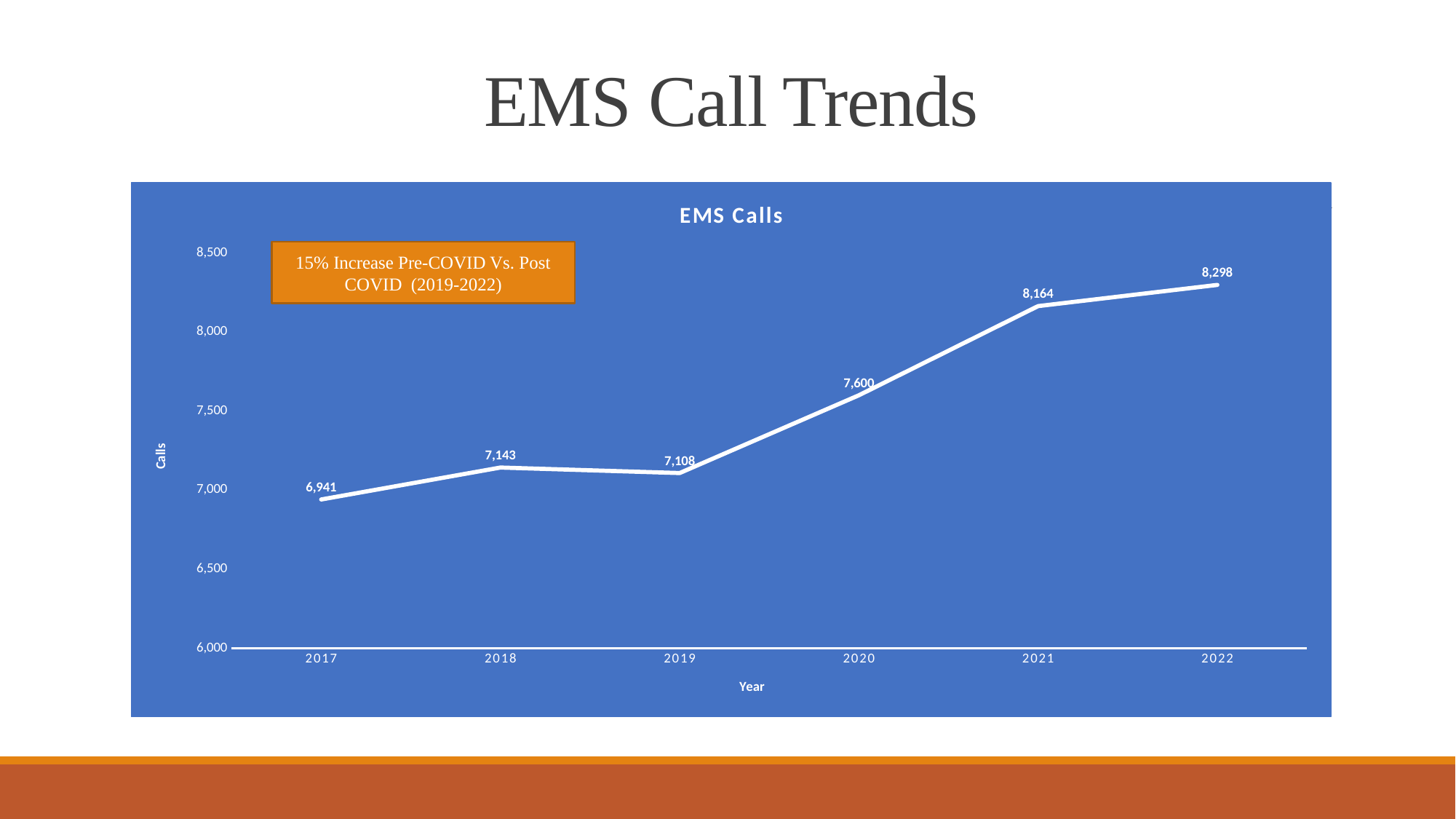
What is the number of EMS calls in 2017? 6,941 How many years are plotted on the chart? 6 What kind of chart is shown on the slide? line chart Which year has the lowest number of EMS calls? 2017 What is the difference in EMS calls between 2021 and 2020? 564 What is the number of EMS calls in 2020? 7,600 What is the number of EMS calls in 2022? 8,298 What is the title of the chart? EMS Calls Which year had more EMS calls, 2018 or 2019? 2018 Which year has the highest number of EMS calls? 2022 Is the value for 2021 greater or less than 8,000? greater What is the difference in EMS calls between 2022 and 2019? 1,190